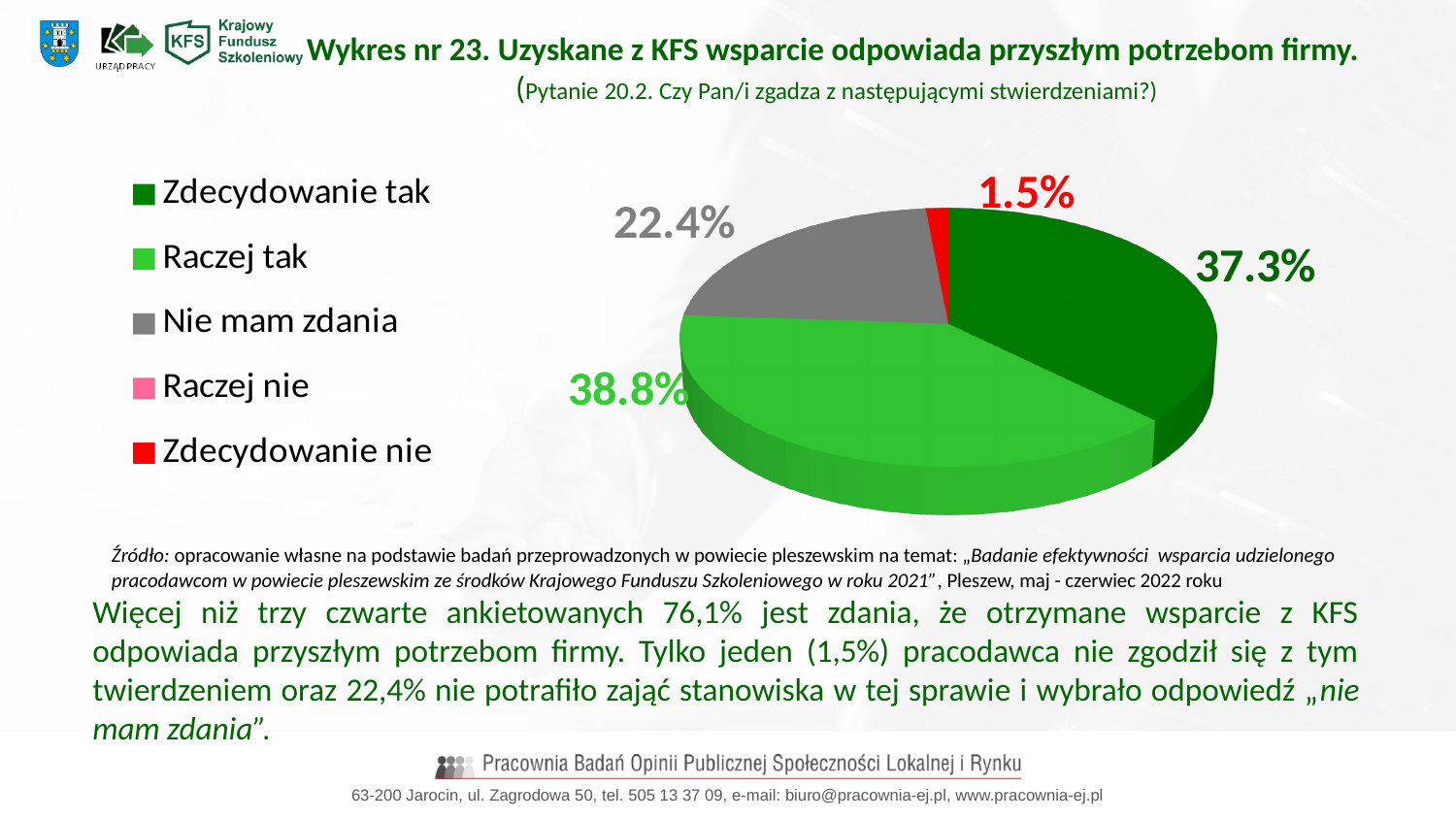
How many entries does the legend list? 5 Which answer category with a visible slice has the smallest share of the pie? Zdecydowanie nie What colour is the slice for "Nie mam zdania"? gray Which is larger: the share for "Nie mam zdania" or the share for "Zdecydowanie nie"? Nie mam zdania What share of respondents answered "Raczej tak"? 38.8% Which answer category has the largest share of the pie? Raczej tak What type of chart is shown on the slide? pie chart What is the combined share of "Zdecydowanie tak" and "Raczej tak"? 76.1% What share of respondents answered "Nie mam zdania"? 22.4% What share of respondents answered "Zdecydowanie nie"? 1.5% What share of respondents answered "Zdecydowanie tak"? 37.3% What is the difference between the shares for "Raczej tak" and "Zdecydowanie tak"? 1.5%